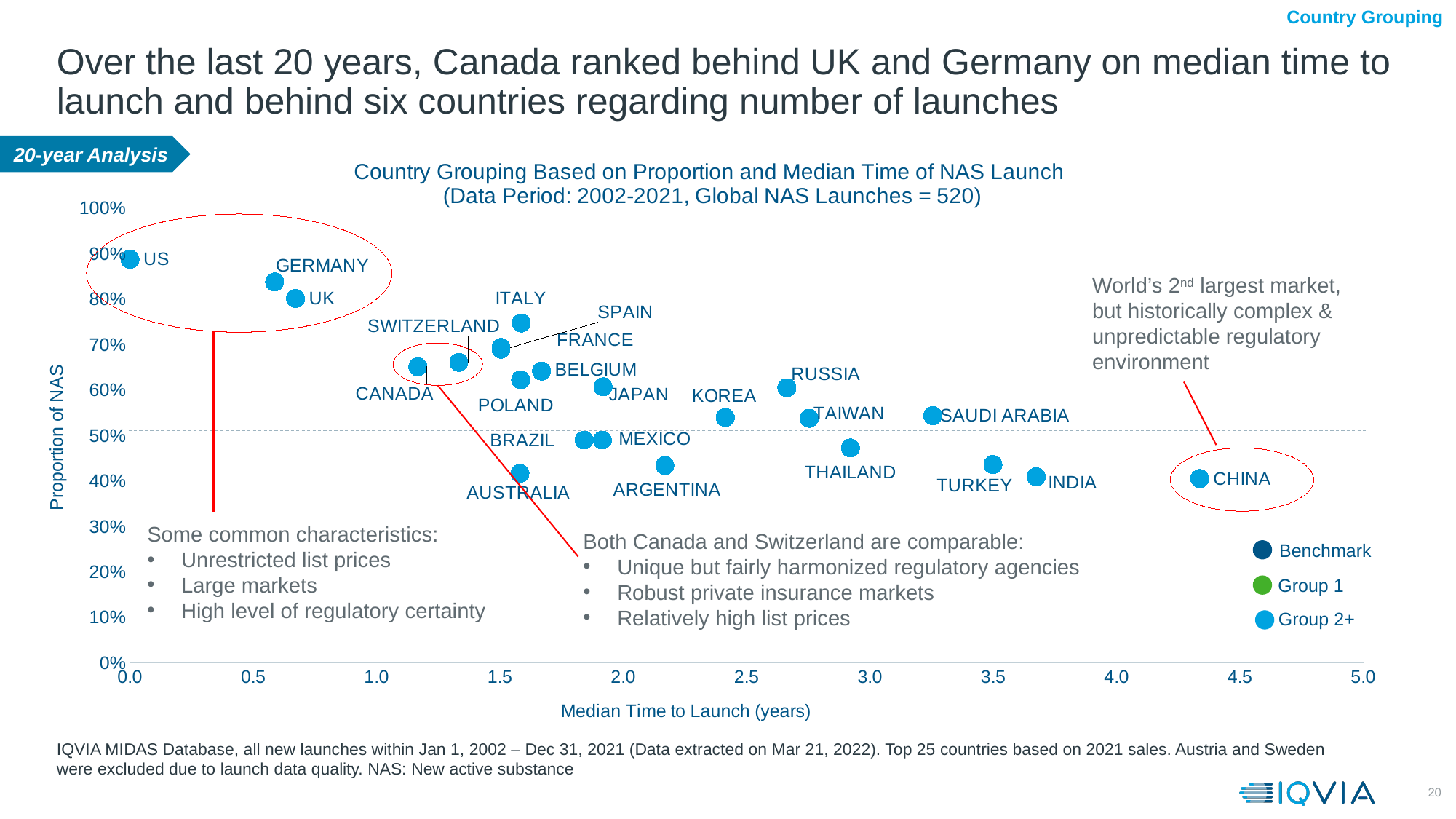
Which country has the highest proportion of NAS? US What kind of chart is shown on the slide? Scatter chart Which country has the longest median time to launch? China Which has the shorter median time to launch, Canada or Switzerland? Canada Which country has the shortest median time to launch? US Is the proportion of NAS for Australia greater or less than 50%? less What is the label of the x axis? Median Time to Launch (years) Is the median time to launch for China greater or less than 4.0 years? greater How many countries are plotted on the chart? 23 Is the proportion of NAS for the US greater or less than 80%? greater How many entries does the legend list? 3